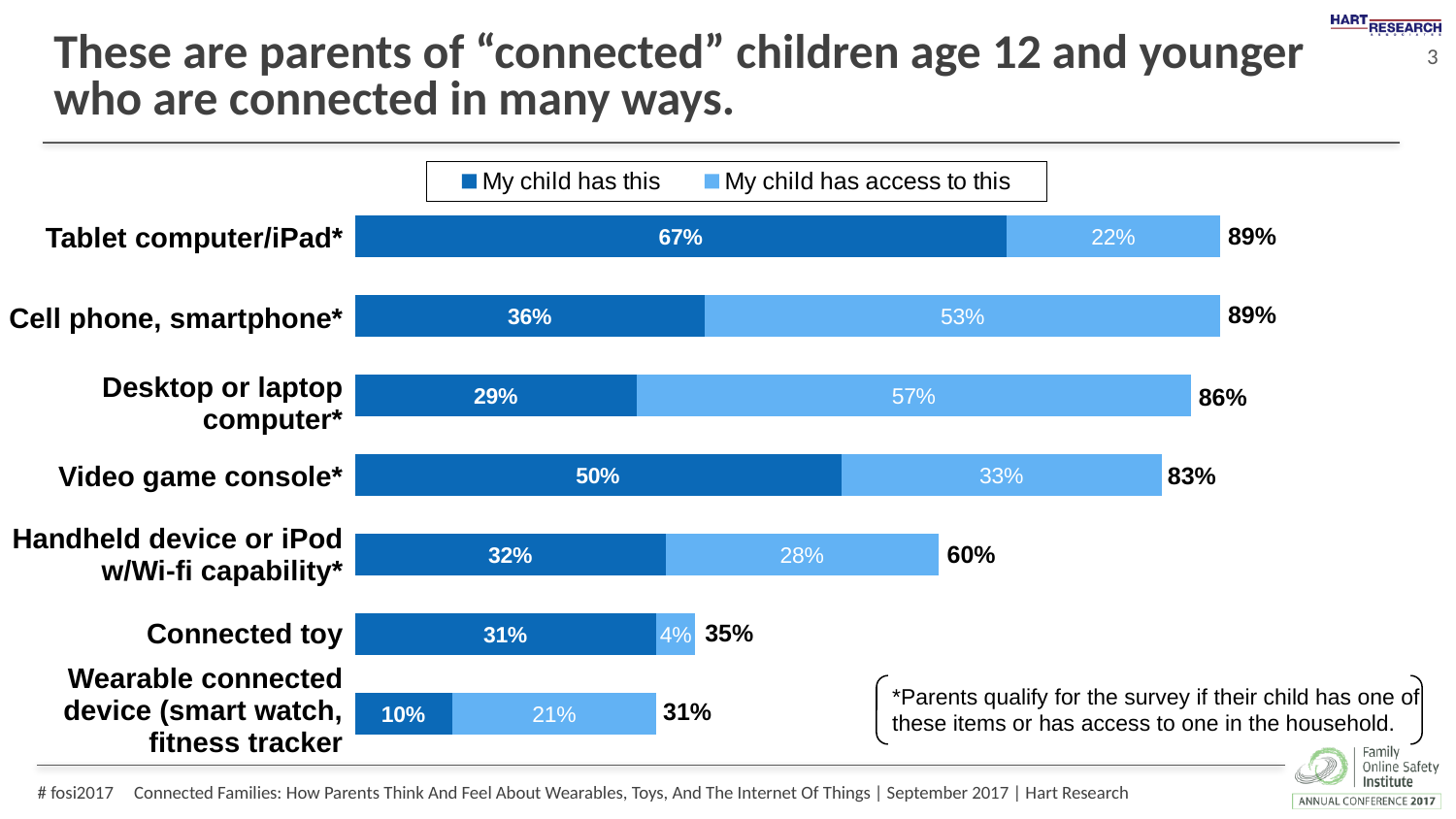
What percentage of parents say their child has a tablet computer/iPad? 67% How many series does the legend list? 2 What percentage of parents say their child has access to a cell phone or smartphone? 53% What is the difference between the 'My child has this' percentage for video game console and for connected toy? 19% Which item has the lowest total percentage? Wearable connected device (smart watch, fitness tracker Which item has the highest 'My child has this' percentage? Tablet computer/iPad* Which is larger: the 'My child has access to this' percentage for desktop or laptop computer, or for handheld device or iPod w/Wi-fi capability? Desktop or laptop computer* What percentage of parents say their child has a video game console? 50% How many items (categories) are shown in the chart? 7 What is the total percentage shown for the desktop or laptop computer bar? 86% What type of chart is shown on the slide? Stacked bar chart What is the total percentage shown for the connected toy bar? 35%